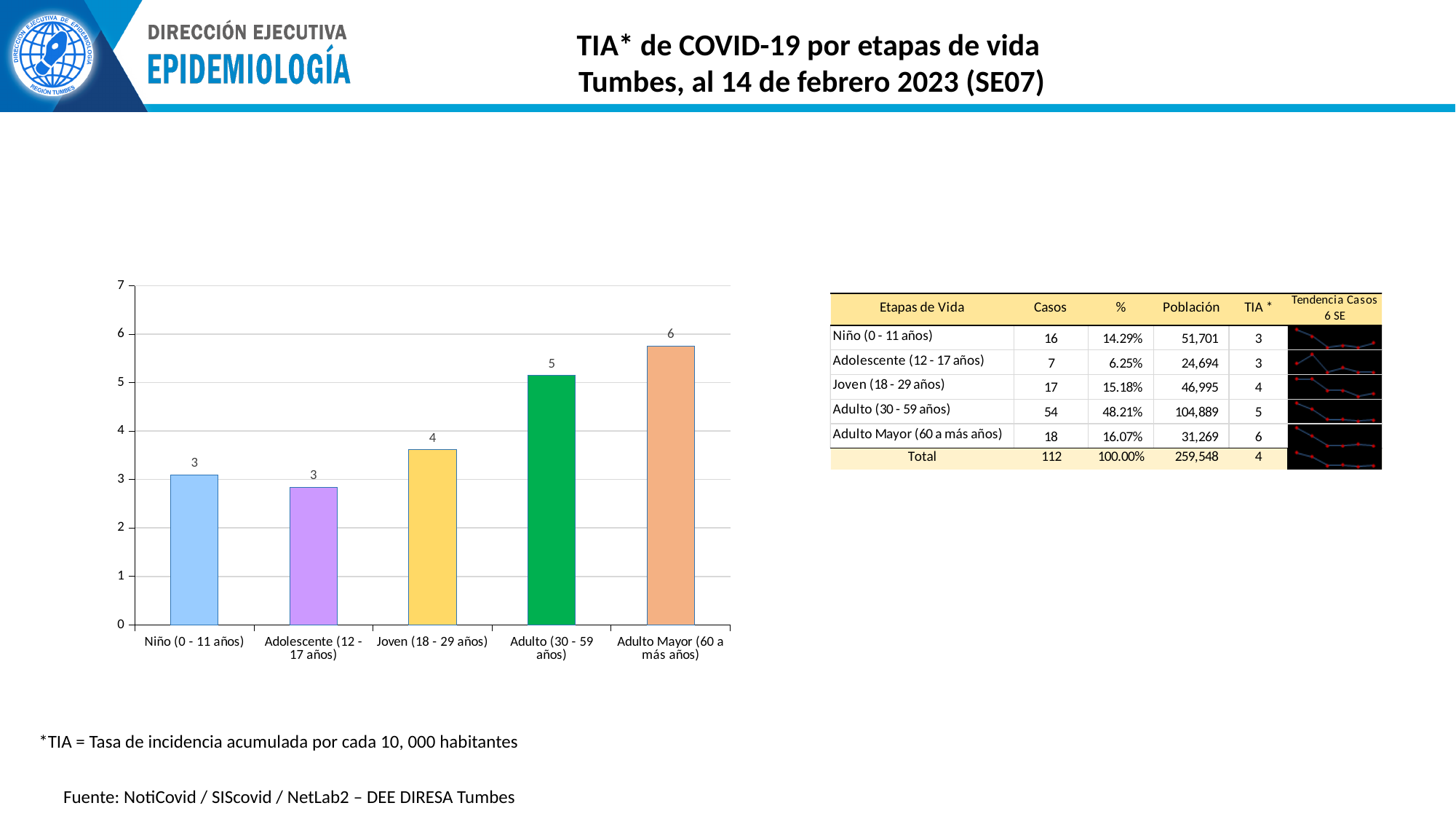
Which life stage has the highest TIA in the bar chart? Adulto Mayor (60 a más años) What type of chart is used to show TIA by life stage? Bar chart Is the bar for Joven (18 - 29 años) greater or less than 4 on the axis? less What colour is the bar for Adulto (30 - 59 años)? Green What is the difference between the labelled TIA values for Adulto Mayor (60 a más años) and Niño (0 - 11 años)? 3 Which has a larger TIA, Adulto (30 - 59 años) or Joven (18 - 29 años)? Adulto (30 - 59 años) How many life-stage categories are shown in the bar chart? 5 What is the TIA value shown for Niño (0 - 11 años)? 3 What is the TIA value shown for Adulto Mayor (60 a más años)? 6 What is the TIA value shown for Adulto (30 - 59 años)? 5 What is the TIA value shown for Joven (18 - 29 años)? 4 Is the bar for Adulto Mayor (60 a más años) greater or less than 5 on the axis? greater